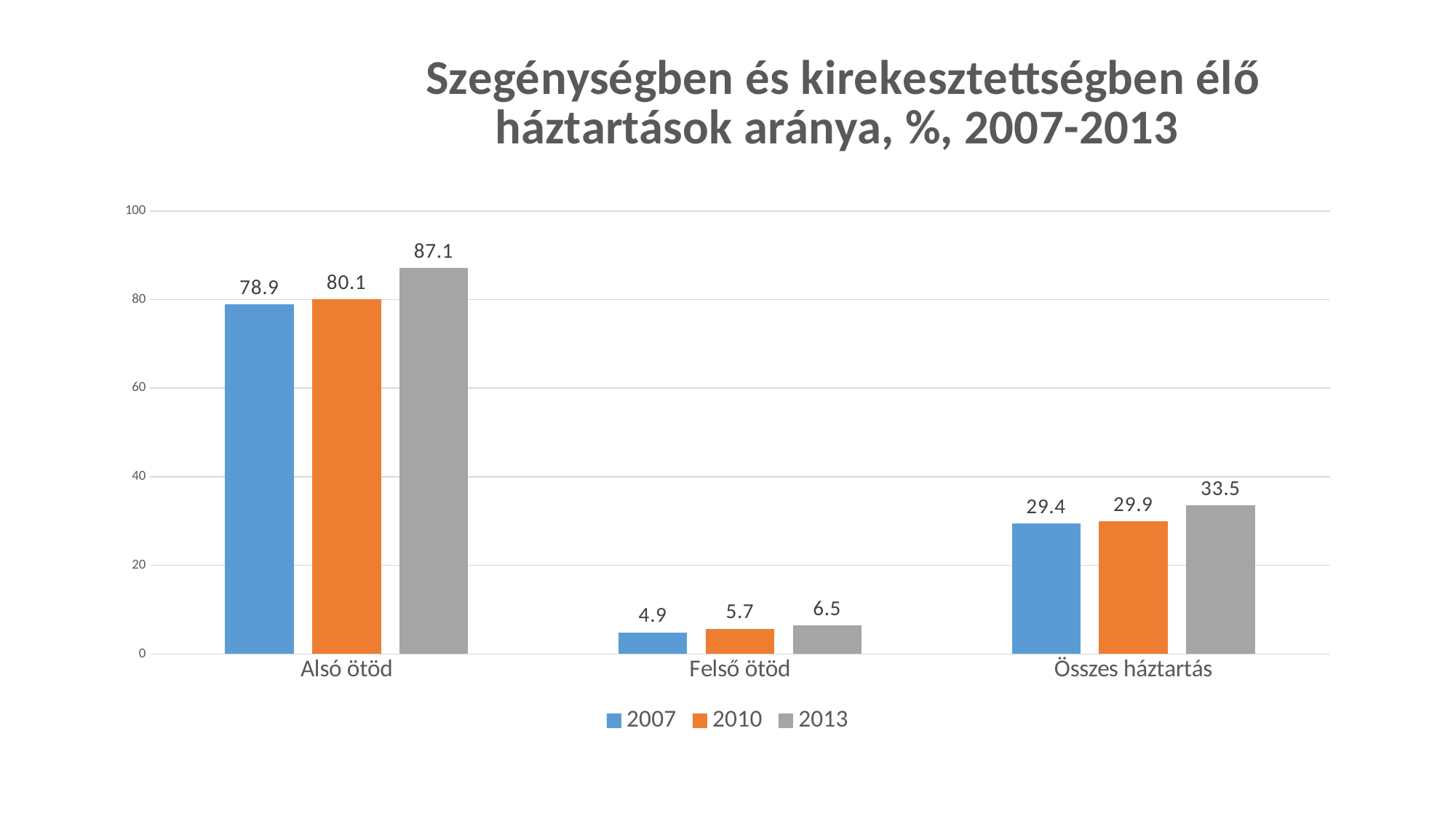
What is the value for Felső ötöd in 2007? 4.9 What kind of chart is shown on the slide? Bar chart Which category has the lowest value in 2007? Felső ötöd How many categories are shown on the x axis? 3 Which category has the highest value in 2013? Alsó ötöd What is the value for Alsó ötöd in 2013? 87.1 What is the value for Összes háztartás in 2010? 29.9 How many series does the legend list? 3 What is the difference between the 2013 and 2010 values for Összes háztartás? 3.6 Which is larger for Felső ötöd: the 2010 value or the 2013 value? 2013 What is the difference between the 2013 and 2007 values for Alsó ötöd? 8.2 Do the values for Összes háztartás rise or fall from 2007 to 2013? Rise